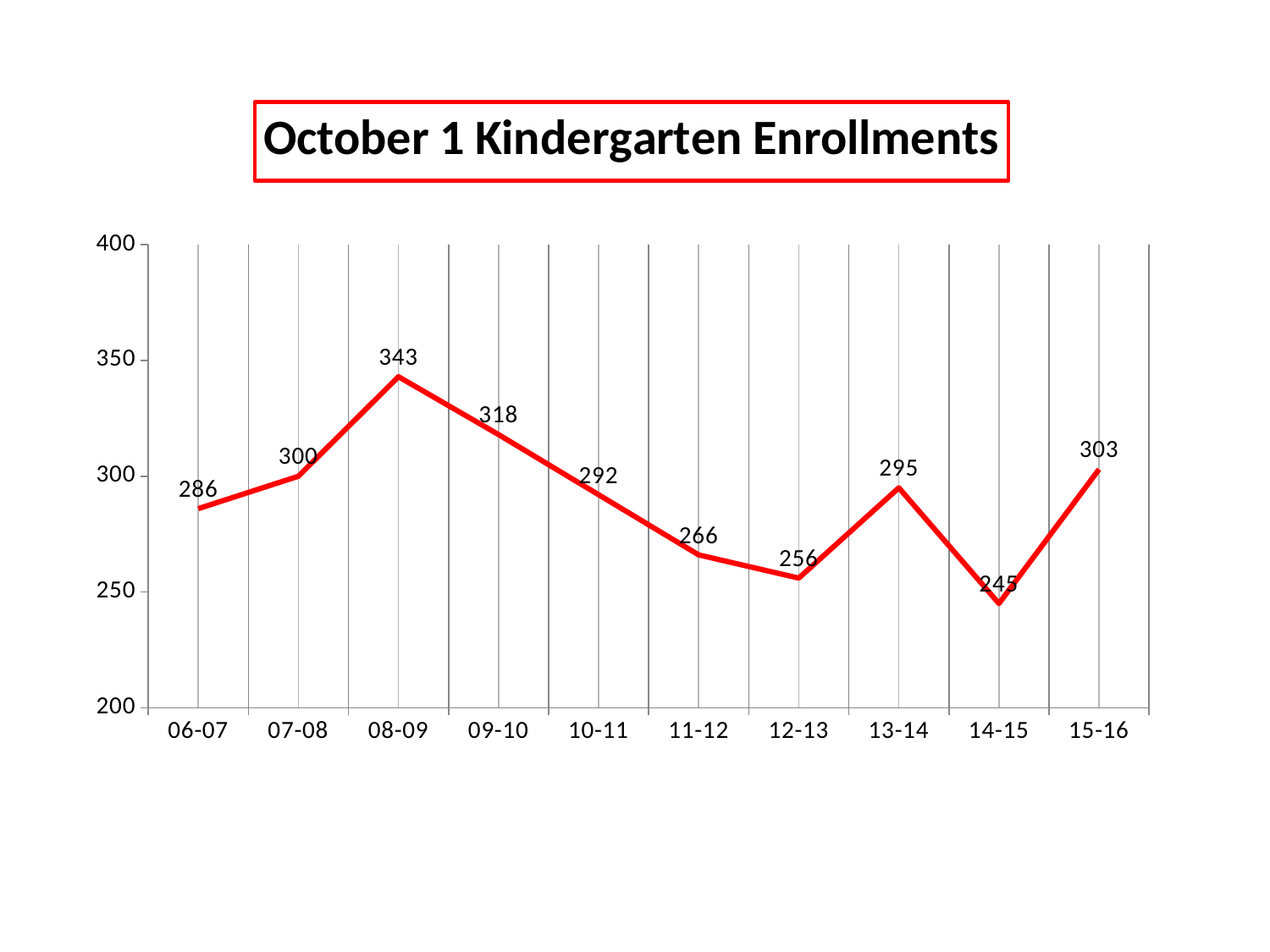
What is the enrollment value for 08-09? 343 Is the value for 12-13 greater or less than 300? less What is the title of the chart? October 1 Kindergarten Enrollments How many years are plotted on the chart? 10 Which is larger, the enrollment for 09-10 or for 13-14? 09-10 Which year has the lowest enrollment? 14-15 What is the difference between the enrollments for 15-16 and 14-15? 58 What is the enrollment value for 15-16? 303 What is the enrollment value for 14-15? 245 Which year has the highest enrollment? 08-09 What is the difference between the enrollments for 08-09 and 14-15? 98 What kind of chart is shown? line chart